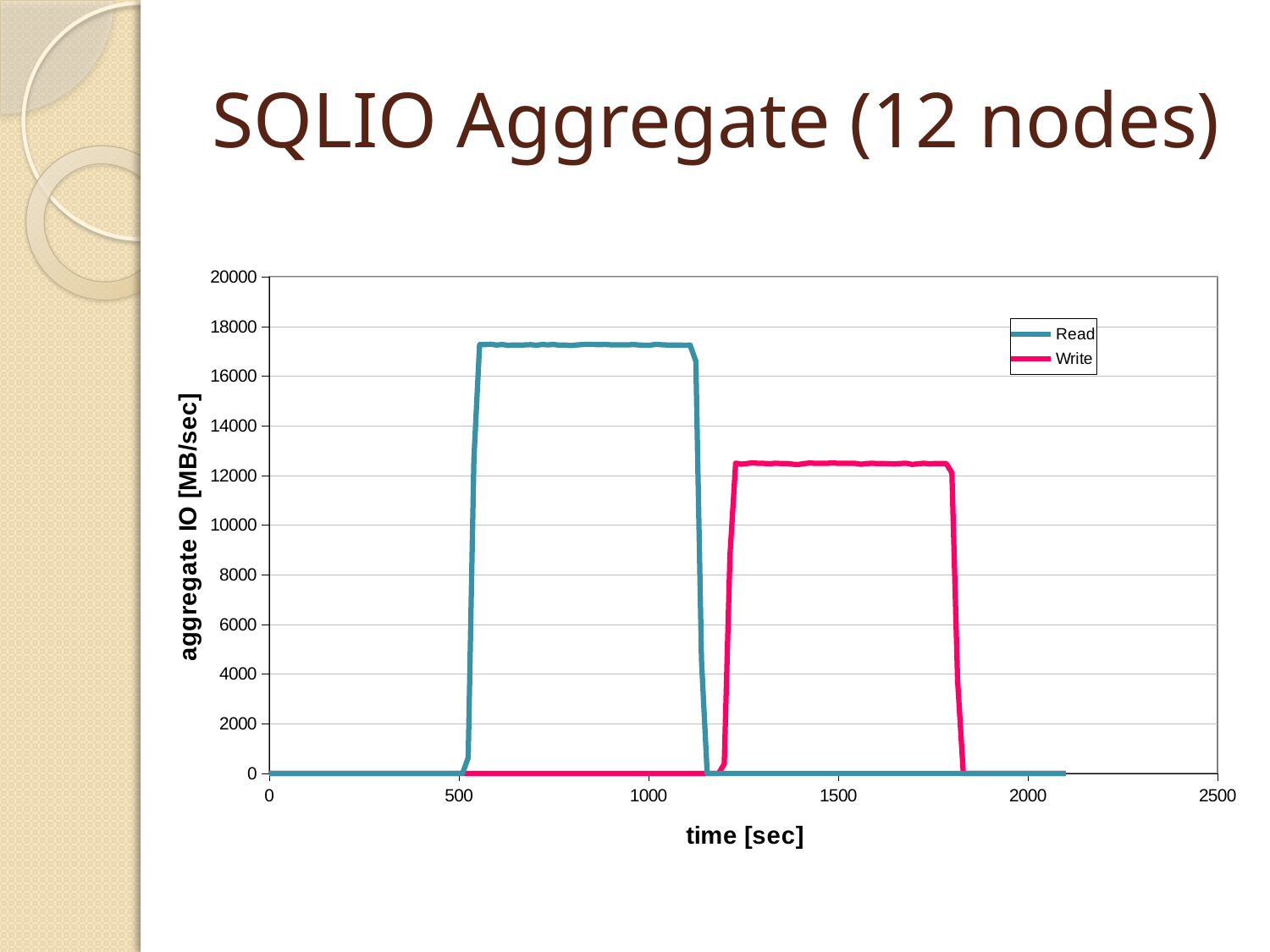
What is the label of the y axis? aggregate IO [MB/sec] How many series does the legend list? 2 What kind of chart is shown on the slide? line chart Does the Write series rise or fall between time 1750 sec and 1850 sec? fall Which series reaches the higher plateau, Read or Write? Read At time 1500 sec, which series has the larger value, Read or Write? Write At time 800 sec, which series has the larger value, Read or Write? Read Is the plateau value for Write greater or less than 14000? less Is the plateau value for Write greater or less than 12000? greater Is the plateau value for Read greater or less than 16000? greater What are the two series named in the legend? Read and Write Which series has the highest value anywhere on the chart? Read